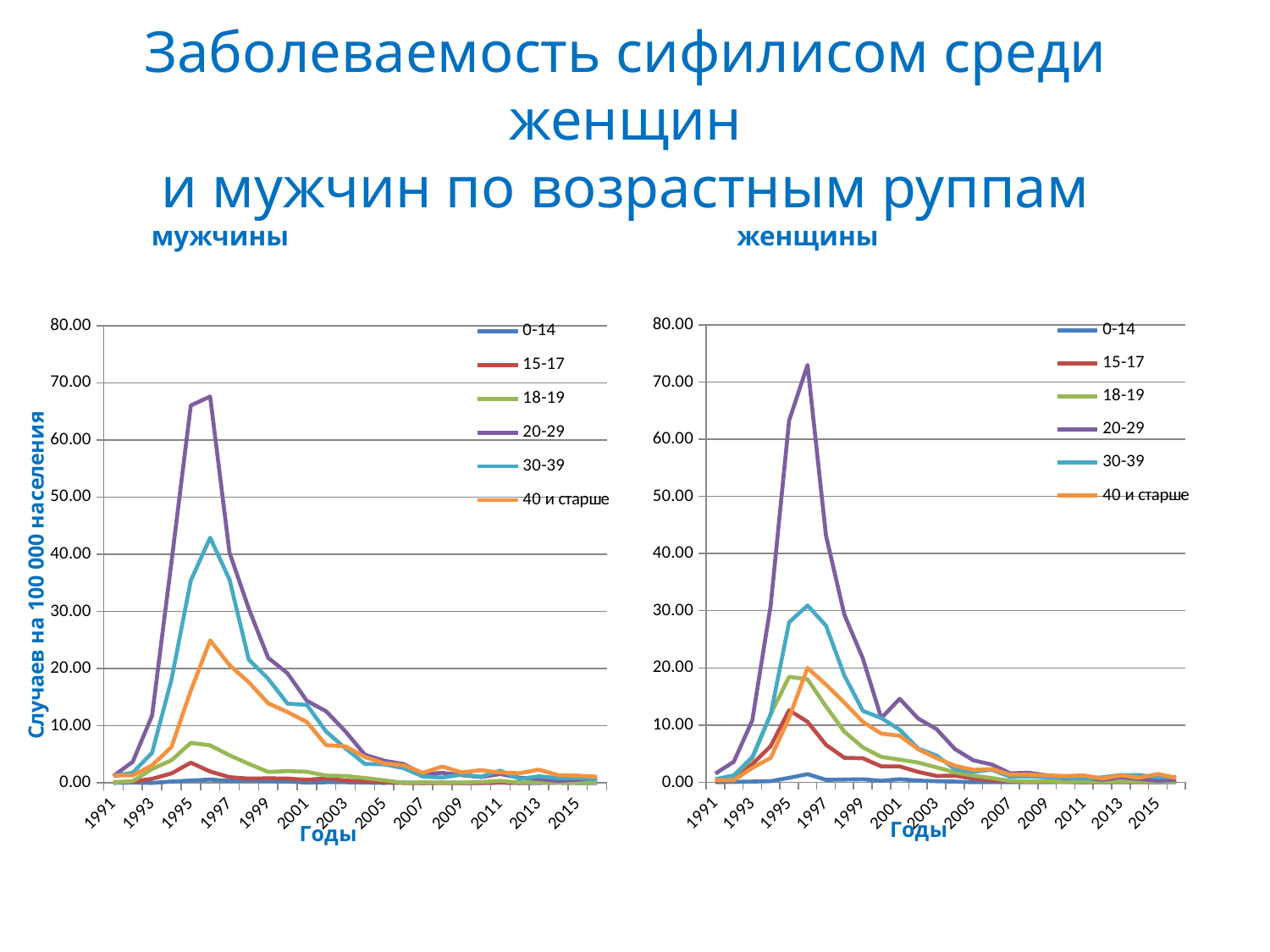
In the right chart ("женщины"), is the peak value of the 18-19 series greater or less than 20? less In the left chart ("мужчины"), do the values for the 20-29 series rise or fall between 1997 and 2005? fall What kind of chart is the left chart titled "мужчины"? line chart In the left chart ("мужчины"), which age group reaches the highest value? 20-29 In the left chart ("мужчины"), is the peak value of the 30-39 series greater or less than 40? greater How many series does the legend of the right chart ("женщины") list? 6 In the right chart ("женщины"), which age group reaches the highest value? 20-29 In the left chart ("мужчины"), is the peak value of the 20-29 series greater or less than 60? greater Which chart shows a higher peak for the 20-29 age group, "мужчины" or "женщины"? женщины In the left chart ("мужчины"), which age group stays lowest across the whole period? 0-14 What is the label of the vertical axis on the left chart? Случаев на 100 000 населения